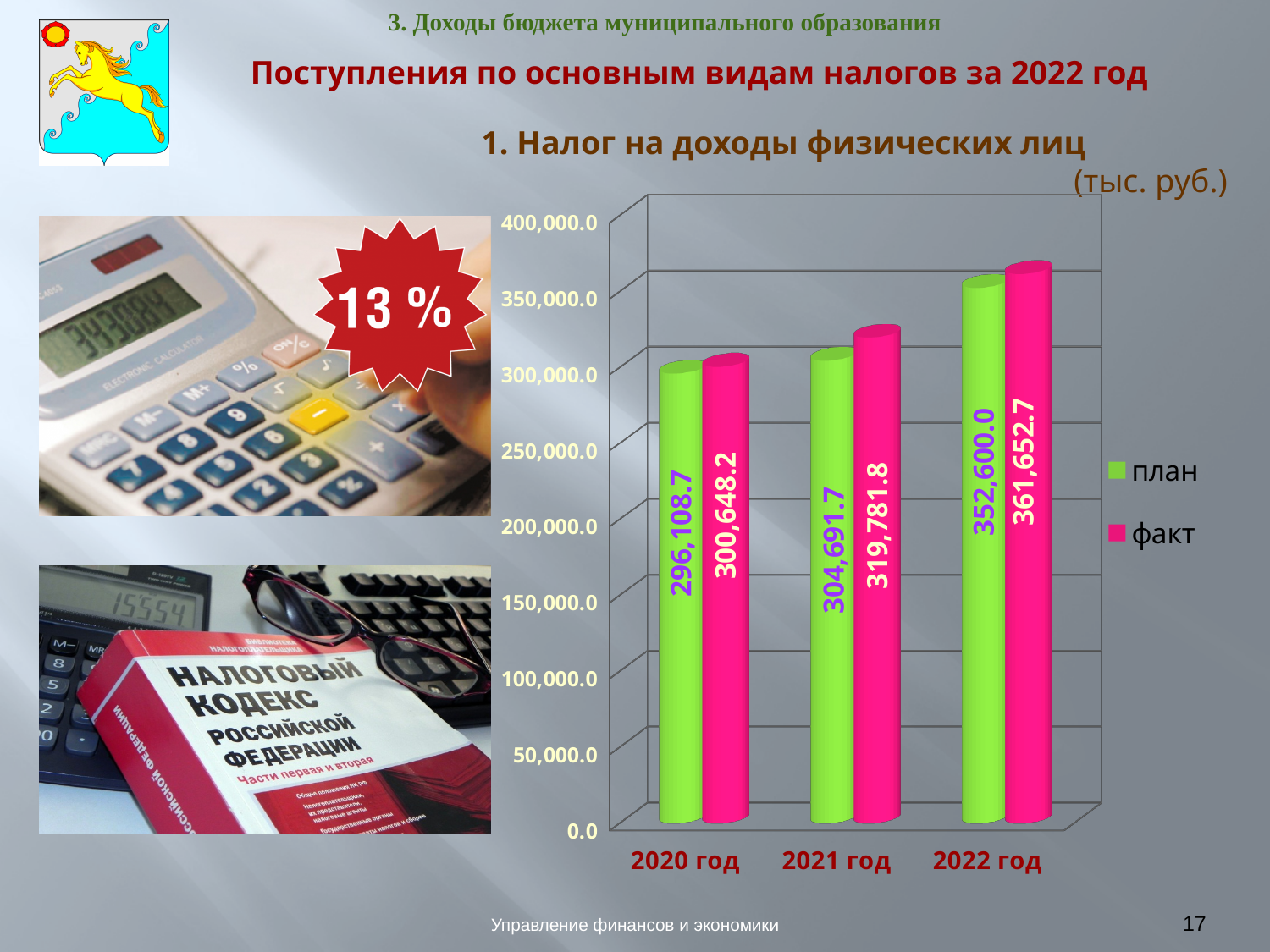
How many years are shown on the x axis? 3 What is the difference between факт and план for 2021 год? 15,090.1 How many series does the legend list? 2 What is the difference between факт and план for 2022 год? 9,052.7 Which is larger for 2020 год, план or факт? факт What is the план value for 2022 год? 352,600.0 What is the план value for 2020 год? 296,108.7 Which year has the highest факт value? 2022 год What is the факт value for 2022 год? 361,652.7 Which year has the lowest план value? 2020 год Do the факт values rise or fall from 2020 год to 2022 год? rise What is the факт value for 2021 год? 319,781.8